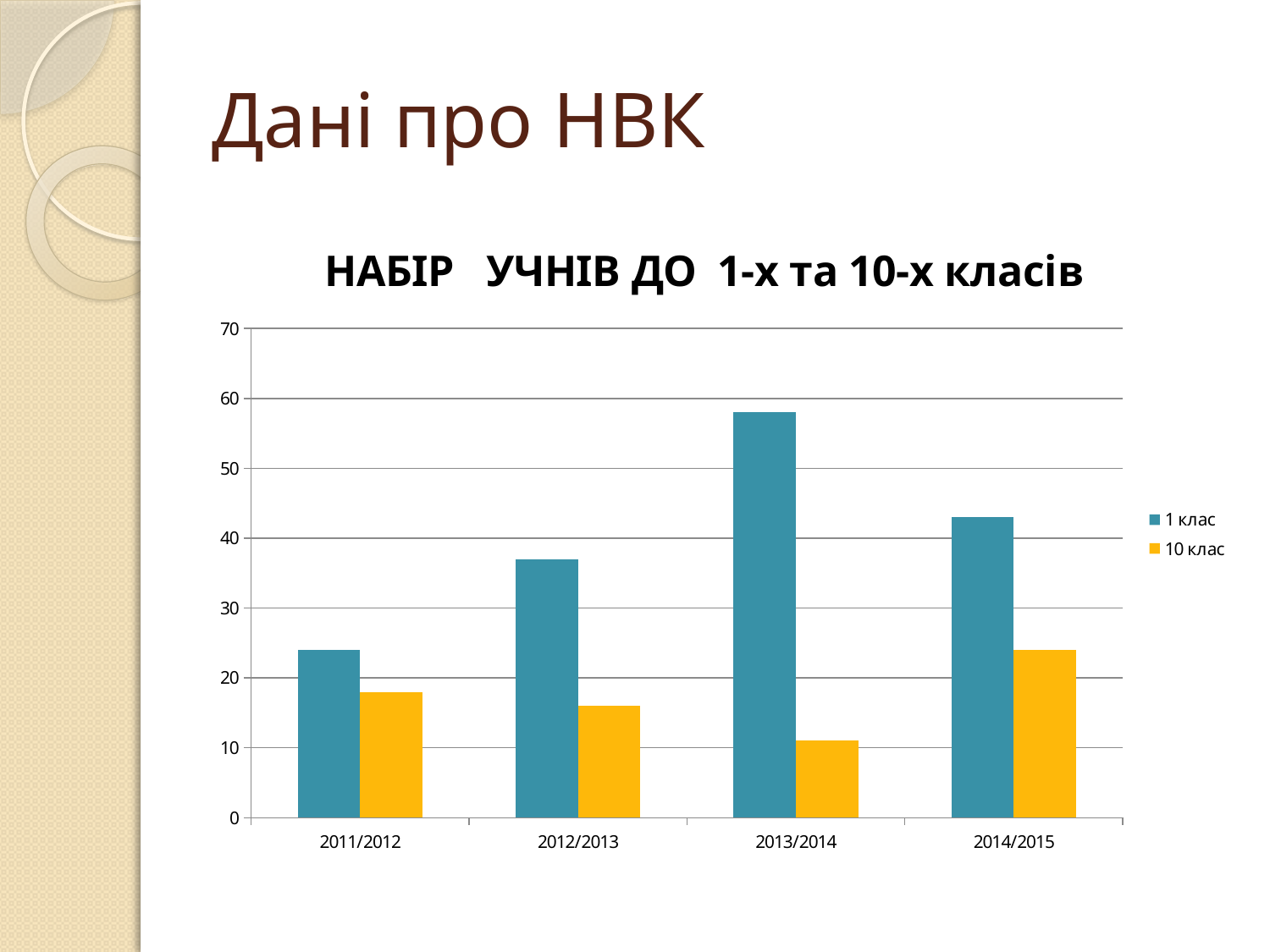
Which is larger in 2014/2015: the value for 1 клас or the value for 10 клас? 1 клас How many school years are shown on the x axis? 4 Is the value for 10 клас in 2012/2013 greater or less than 20? less What kind of chart is shown on the slide? bar chart How many series does the legend list? 2 In which school year is the value for 1 клас lowest? 2011/2012 Is the value for 1 клас in 2013/2014 greater or less than 50? greater What is the title of the chart? НАБІР УЧНІВ ДО 1-х та 10-х класів In which school year is the value for 10 клас lowest? 2013/2014 Which colour represents the 10 клас series in the legend? yellow In which school year is the value for 1 клас highest? 2013/2014 In which school year is the value for 10 клас highest? 2014/2015